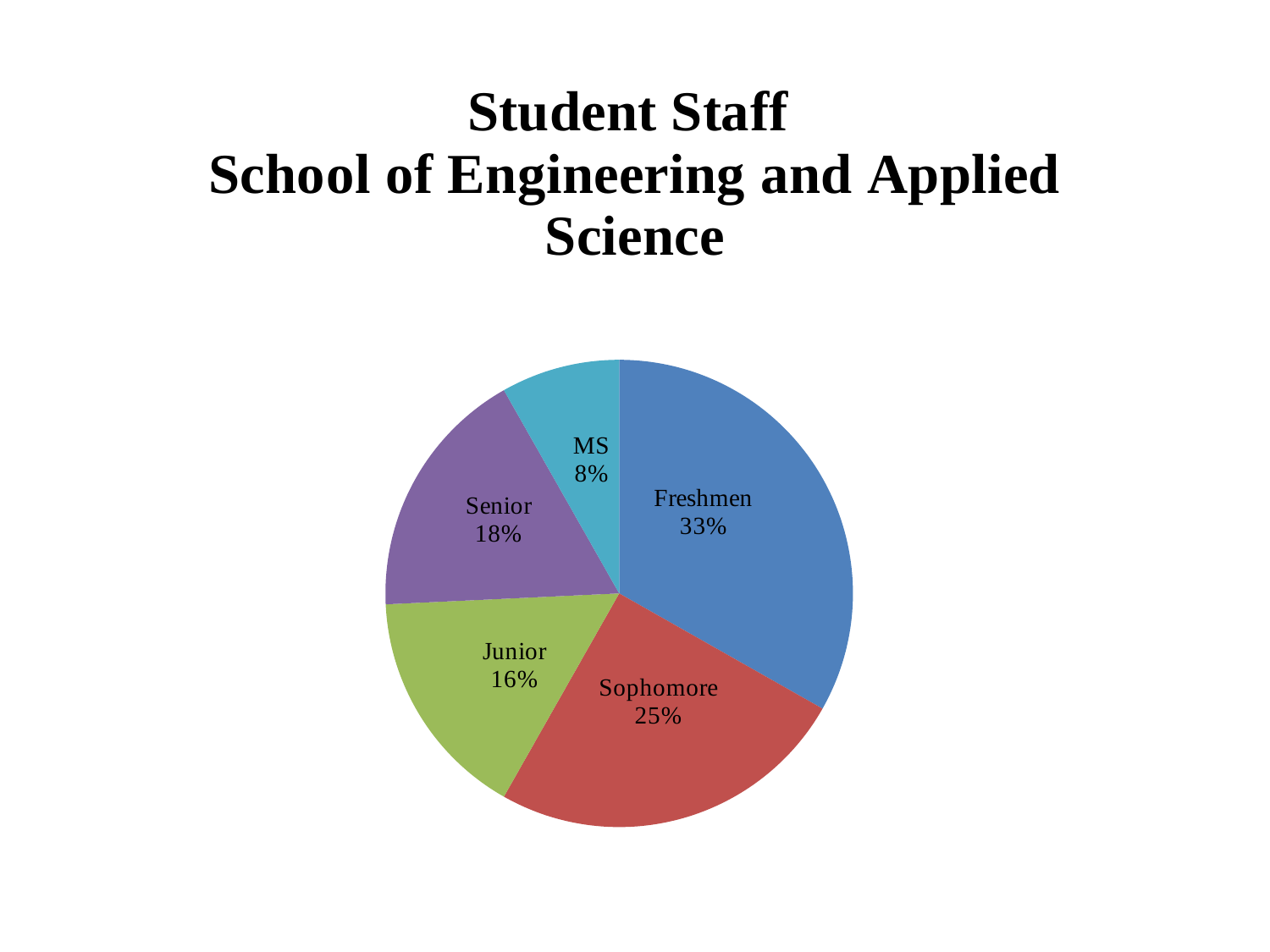
Which category has the largest slice of the pie? Freshmen What is the difference in percentage points between the Freshmen and Sophomore slices? 8 What percentage is shown for the Sophomore slice? 25% What percentage is shown for the MS slice? 8% What share of the pie does the Freshmen slice represent? 33% How many categories are shown in the pie chart? 5 What kind of chart is shown on the slide? Pie chart What colour is the Sophomore slice? Red Which slice is larger, Senior or Junior? Senior What percentage is shown for the Junior slice? 16% What percentage is shown for the Senior slice? 18% Which category has the smallest slice of the pie? MS